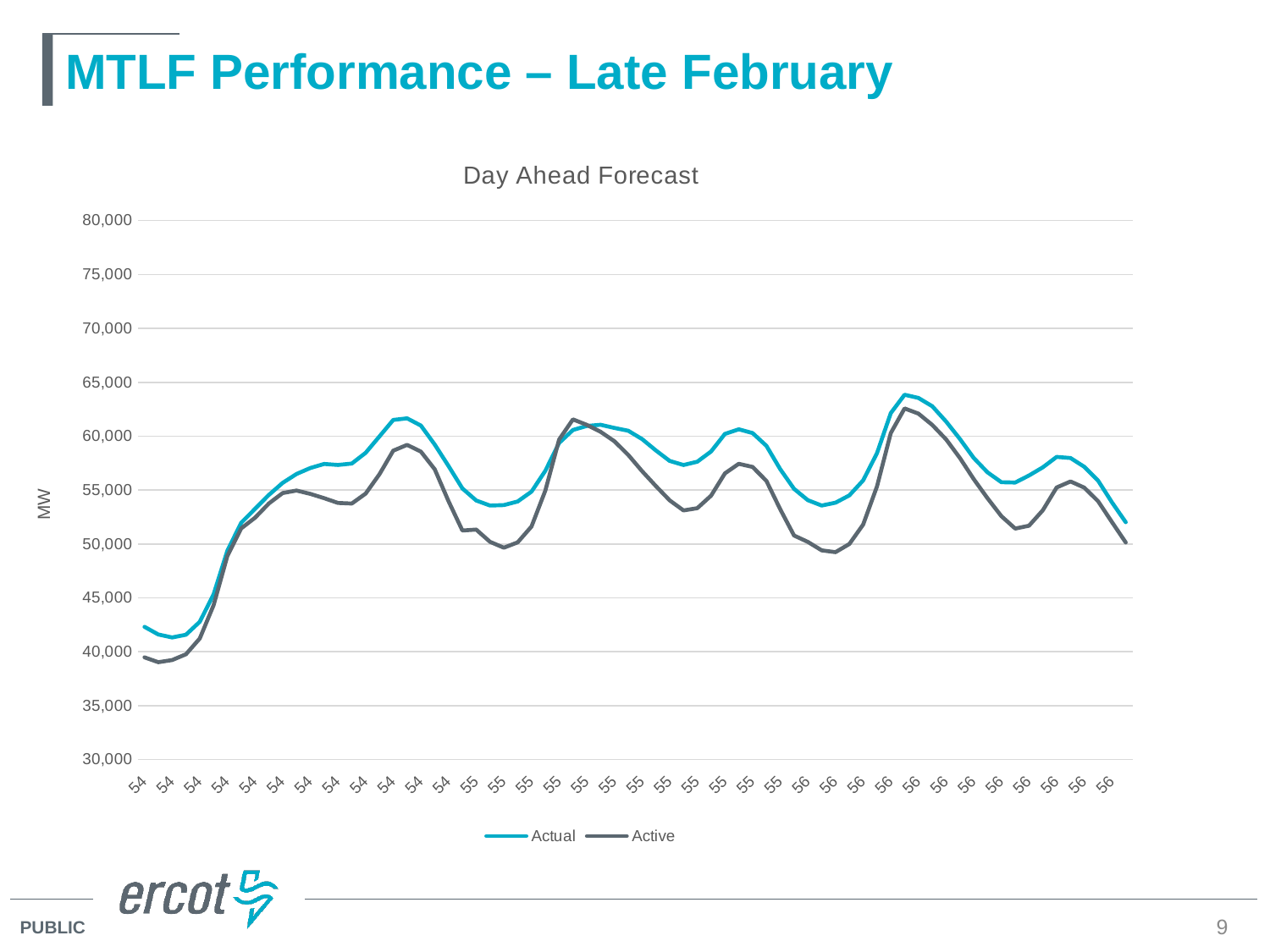
What unit is shown on the vertical axis of the chart? MW Is the highest peak of the Active series greater or less than 65,000? less What is the highest value shown on the vertical axis of the chart? 80,000 What is the lowest value shown on the vertical axis of the chart? 30,000 At the first point on the left of the chart, which series has the higher value, Actual or Active? Actual Which series reaches the higher overall peak in the chart, Actual or Active? Actual What kind of chart is shown on the slide? Line chart What are the two series named in the chart legend? Actual and Active How many series does the legend of the chart list? 2 Is the highest peak of the Actual series greater or less than 60,000? greater What is the title of the chart? Day Ahead Forecast Is the lowest point of the Active series greater or less than 40,000? less